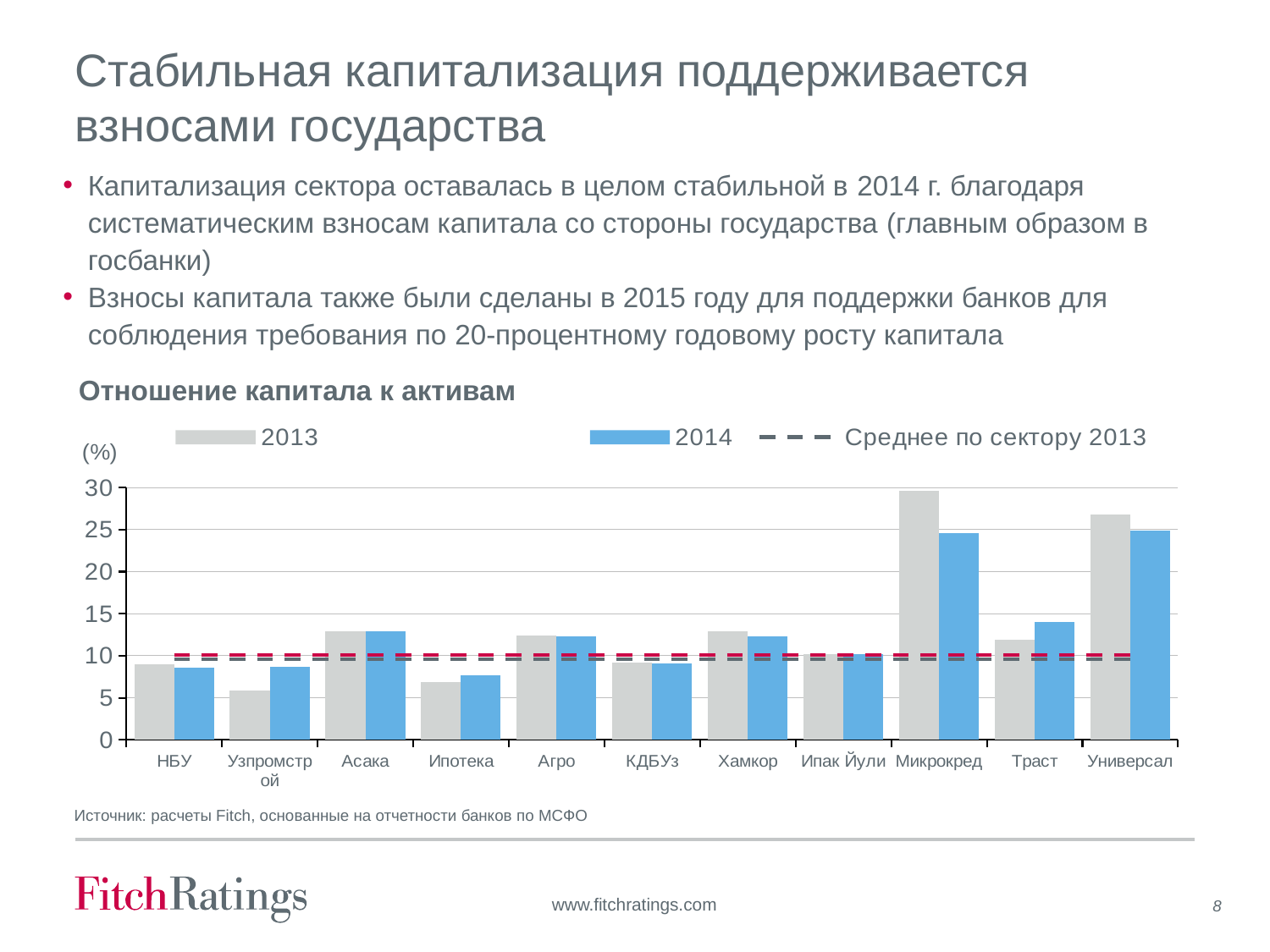
Which bank has the lowest 2013 value in the chart? Узпромстрой Is the 2013 value for Ипотека greater or less than 10? less How many entries does the chart legend list? 3 Which bank has the highest 2013 value in the chart? Микрокред Is the 2013 value for Универсал greater or less than 25? greater For Узпромстрой, which is larger: the 2013 value or the 2014 value? 2014 Is the 2014 value for Микрокред greater or less than 20? greater How many banks (categories) are shown on the x axis of the chart? 11 What kind of chart is shown on the slide? bar chart What is the title of the chart? Отношение капитала к активам For Микрокред, which is larger: the 2013 value or the 2014 value? 2013